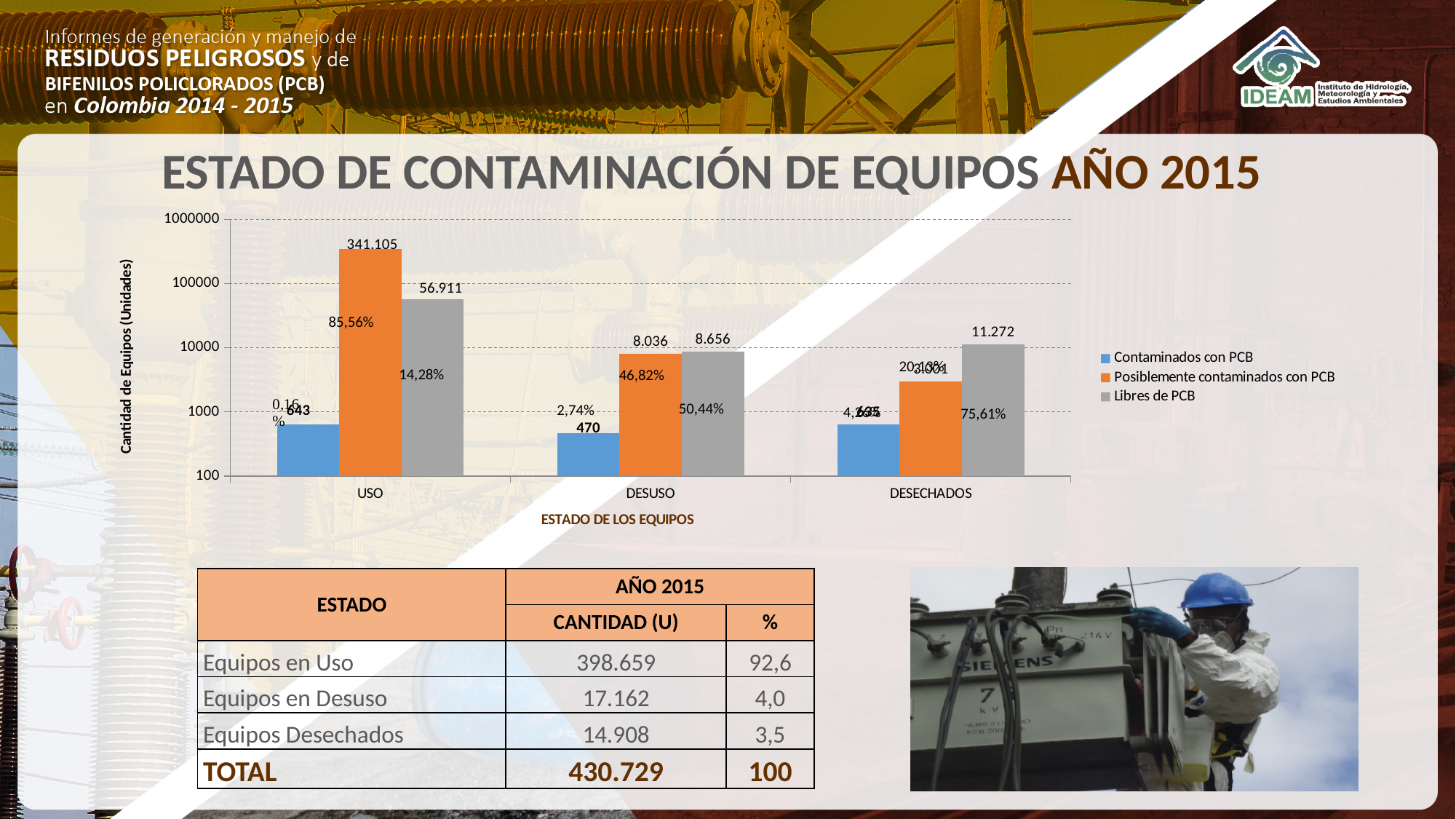
Which category has the highest value for Posiblemente contaminados con PCB? USO How many categories are shown on the x axis of the chart? 3 Which series has the lowest value in the USO category? Contaminados con PCB What is the title of the x axis of the chart? ESTADO DE LOS EQUIPOS How many series does the chart legend list? 3 What percentage label is shown for Libres de PCB in the DESECHADOS category? 75,61% What is the value for Libres de PCB in the DESECHADOS category? 11.272 What is the value for Posiblemente contaminados con PCB in the USO category? 341.105 What is the value for Contaminados con PCB in the DESUSO category? 470 What kind of chart is shown on the slide? bar chart What is the value for Libres de PCB in the USO category? 56.911 Is the value for Contaminados con PCB in the DESUSO category greater or less than 1000? less